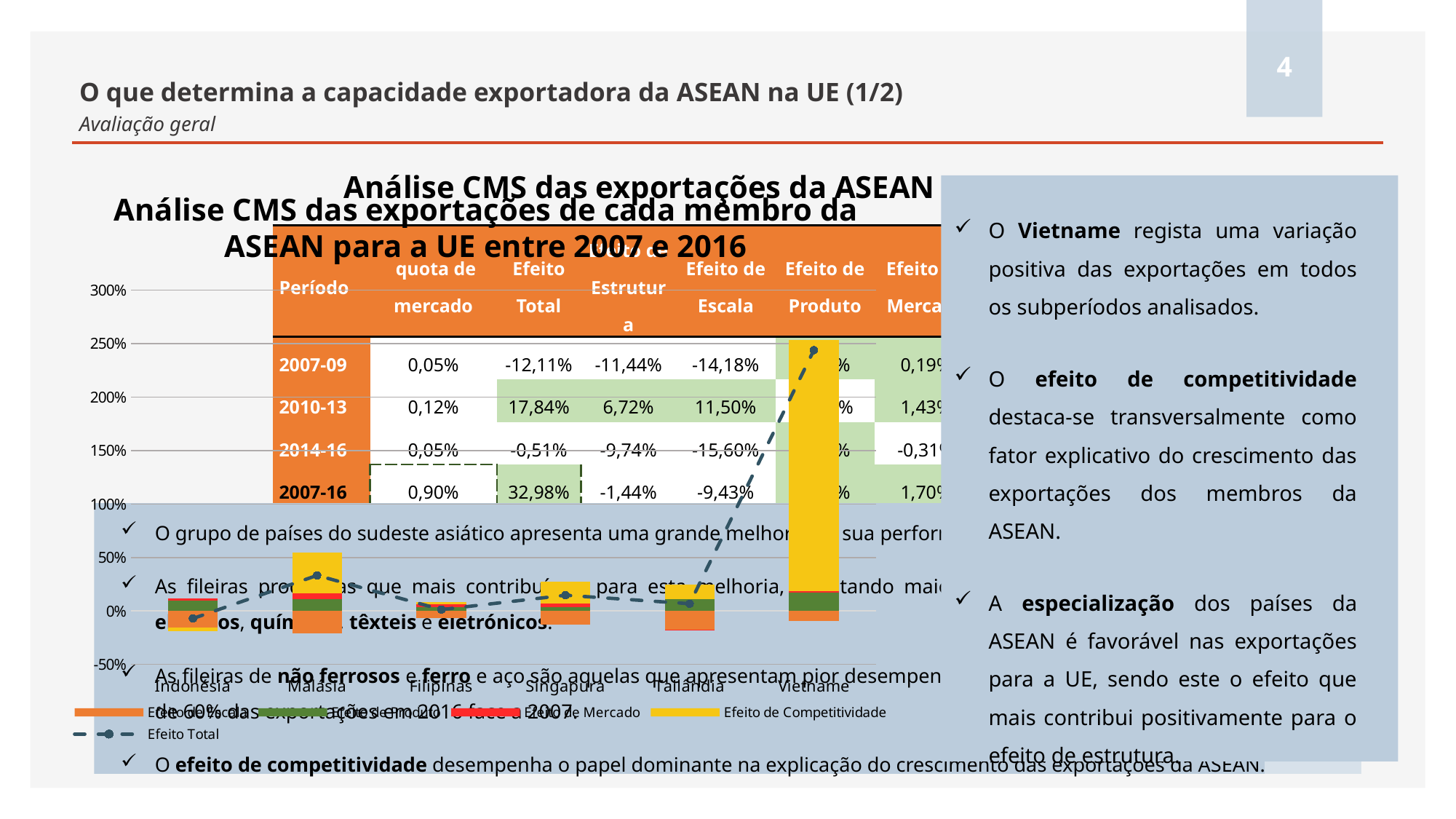
Is the Efeito de Competitividade for Vietname greater or less than 150%? greater Is the Efeito Total for Vietname greater or less than 200%? greater How many countries are shown on the x axis of the chart? 6 Which has a larger Efeito de Competitividade, Malásia or Filipinas? Malásia Is the Efeito Total for Tailândia greater or less than 50%? less Which country has the highest Efeito Total in the chart? Vietname How many series does the chart legend list? 5 Which has a larger Efeito Total, Vietname or Malásia? Vietname What kind of chart is shown on the slide? A stacked bar chart with a line series Which country has the highest Efeito de Competitividade in the chart? Vietname What colour represents Efeito de Competitividade in the chart? Yellow